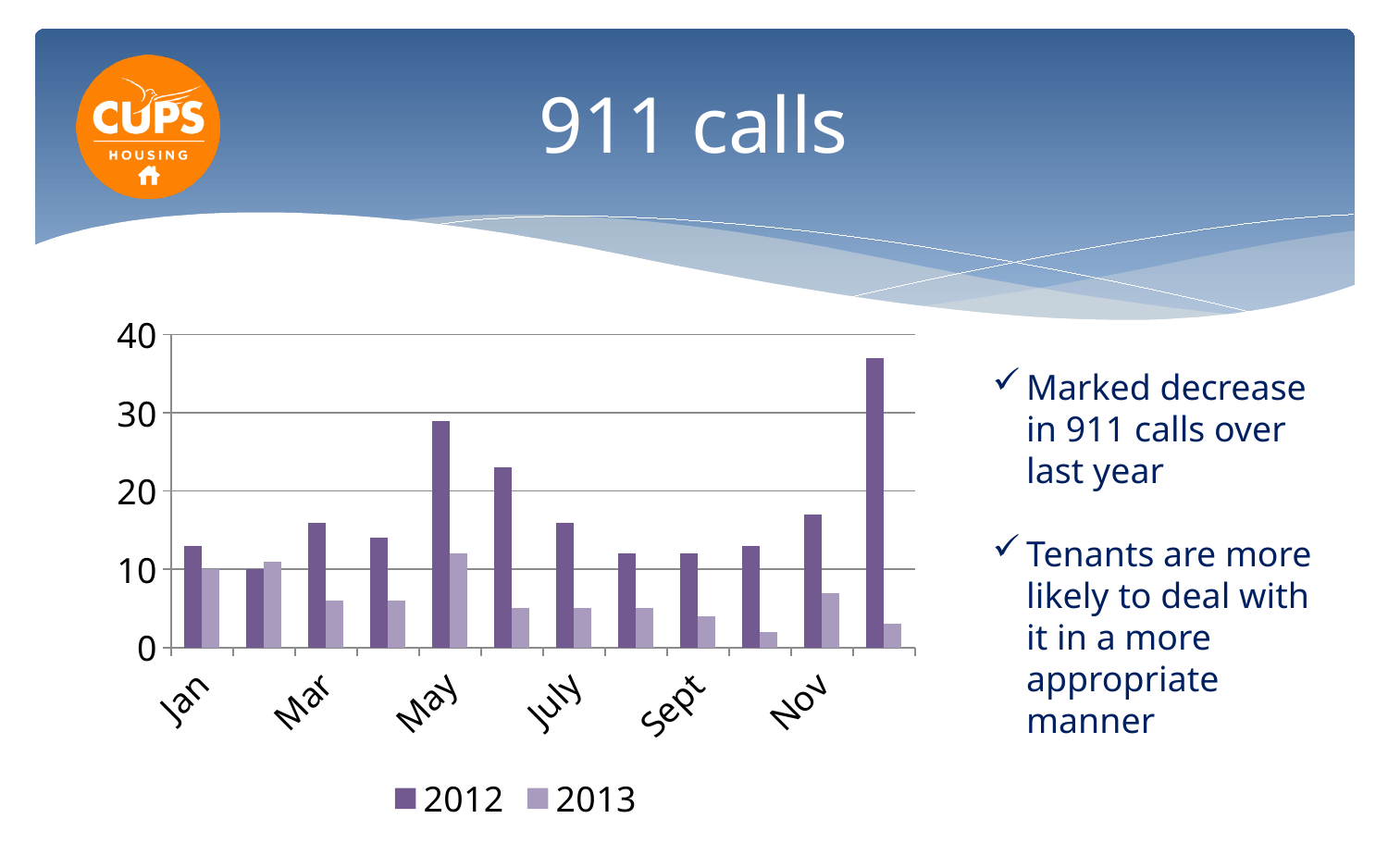
Is the value for 2012 in May greater or less than 20? greater Is the value for 2012 in Nov greater or less than 20? less Which is larger: the 2012 value in May or the 2012 value in July? May Which series is shown in the darker purple colour? 2012 What is the title of the slide containing the chart? 911 calls In Jan, which series has the larger value, 2012 or 2013? 2012 In May, which series has the larger value, 2012 or 2013? 2012 Is the value for 2013 in Sept greater or less than 10? less What kind of chart is shown on the slide? bar chart How many series does the legend list? 2